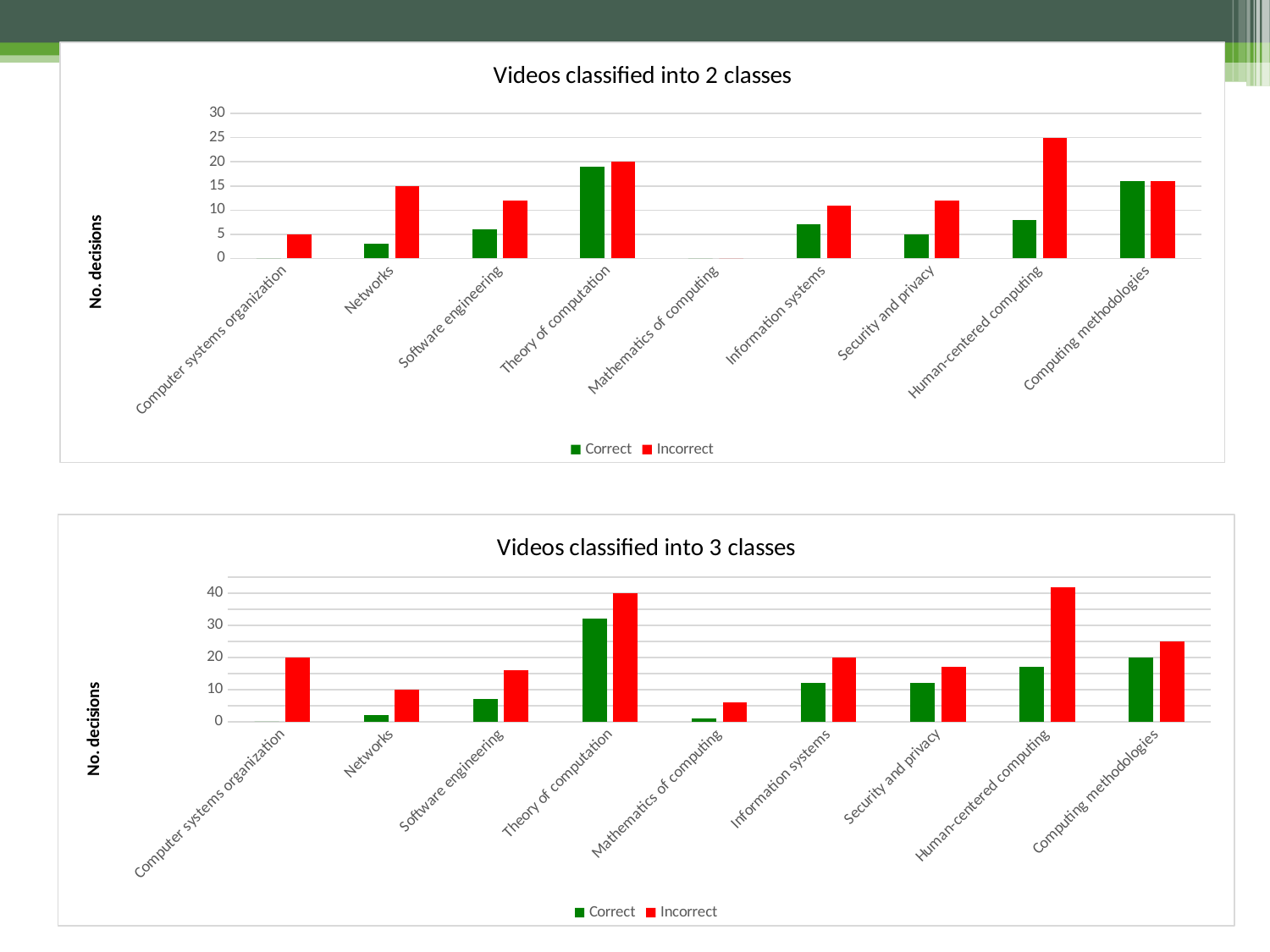
In the chart titled 'Videos classified into 2 classes', which category has the highest Incorrect value? Human-centered computing In the chart titled 'Videos classified into 3 classes', what is the label on the y axis? No. decisions In the chart titled 'Videos classified into 2 classes', what type of chart is shown? bar chart In the chart titled 'Videos classified into 2 classes', is the Incorrect value for Human-centered computing greater or less than 20? greater In the chart titled 'Videos classified into 2 classes', is the Correct value for Networks greater or less than 5? less In the chart titled 'Videos classified into 2 classes', which category has the highest Correct value? Theory of computation In the chart titled 'Videos classified into 2 classes', how many categories are shown on the x axis? 9 In the chart titled 'Videos classified into 2 classes', how many series does the legend list? 2 In the chart titled 'Videos classified into 3 classes', is the Incorrect value for Mathematics of computing greater or less than 10? less In the chart titled 'Videos classified into 2 classes', which is larger for Software engineering, Correct or Incorrect? Incorrect In the chart titled 'Videos classified into 3 classes', which category has the highest Incorrect value? Human-centered computing